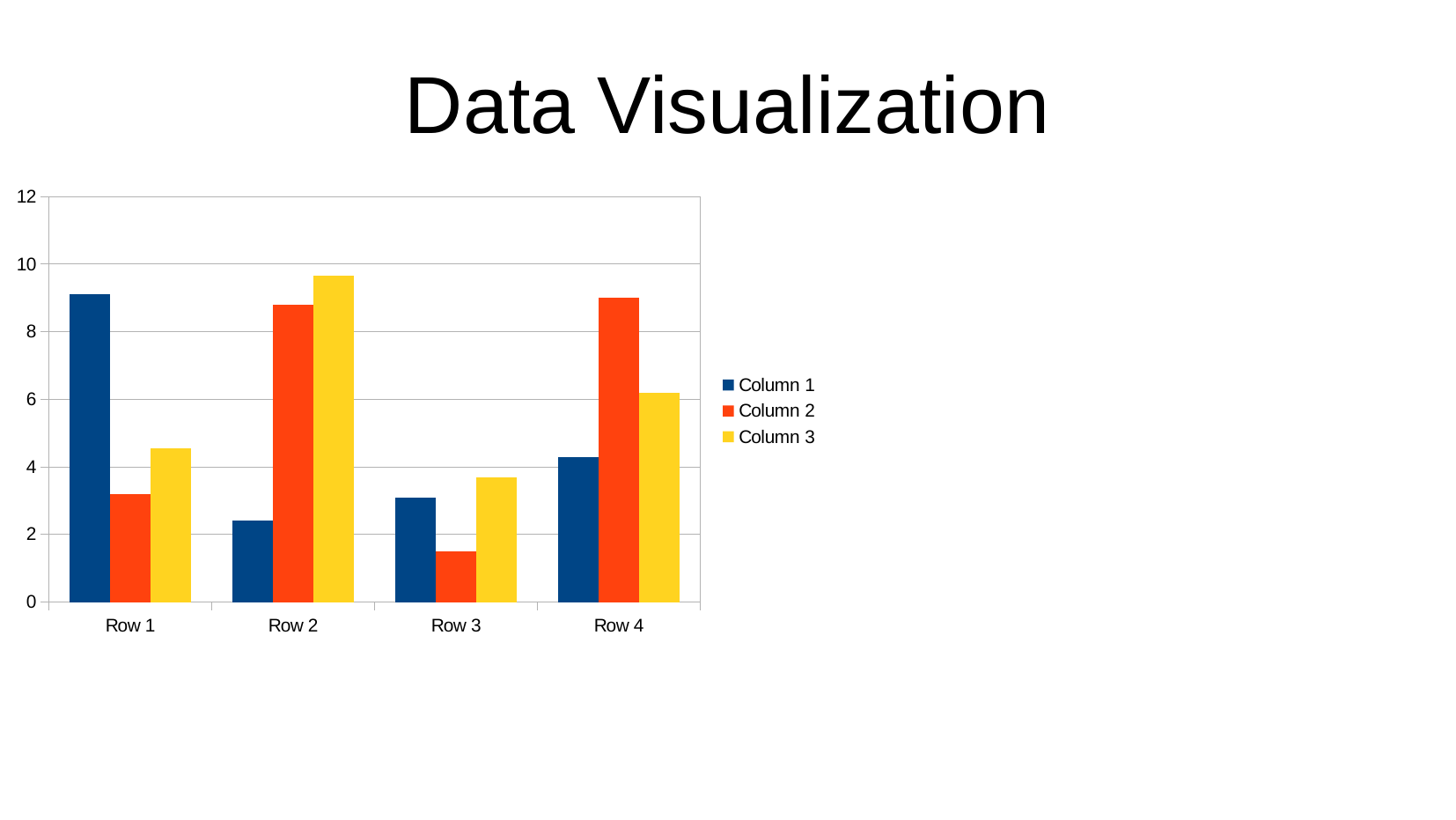
Is the value for Column 2 in Row 3 greater or less than 2? less Which category has the lowest value for Column 1? Row 2 Which category has the highest value for Column 3? Row 2 How many categories are shown on the x axis? 4 How many series does the legend list? 3 What kind of chart is shown on the slide? bar chart In Row 4, which is larger, Column 2 or Column 3? Column 2 What colour are the Column 3 bars? yellow Which category has the highest value for Column 1? Row 1 Which category has the lowest value for Column 2? Row 3 Is the value for Column 1 in Row 1 greater or less than 8? greater Is the value for Column 3 in Row 2 greater or less than 8? greater